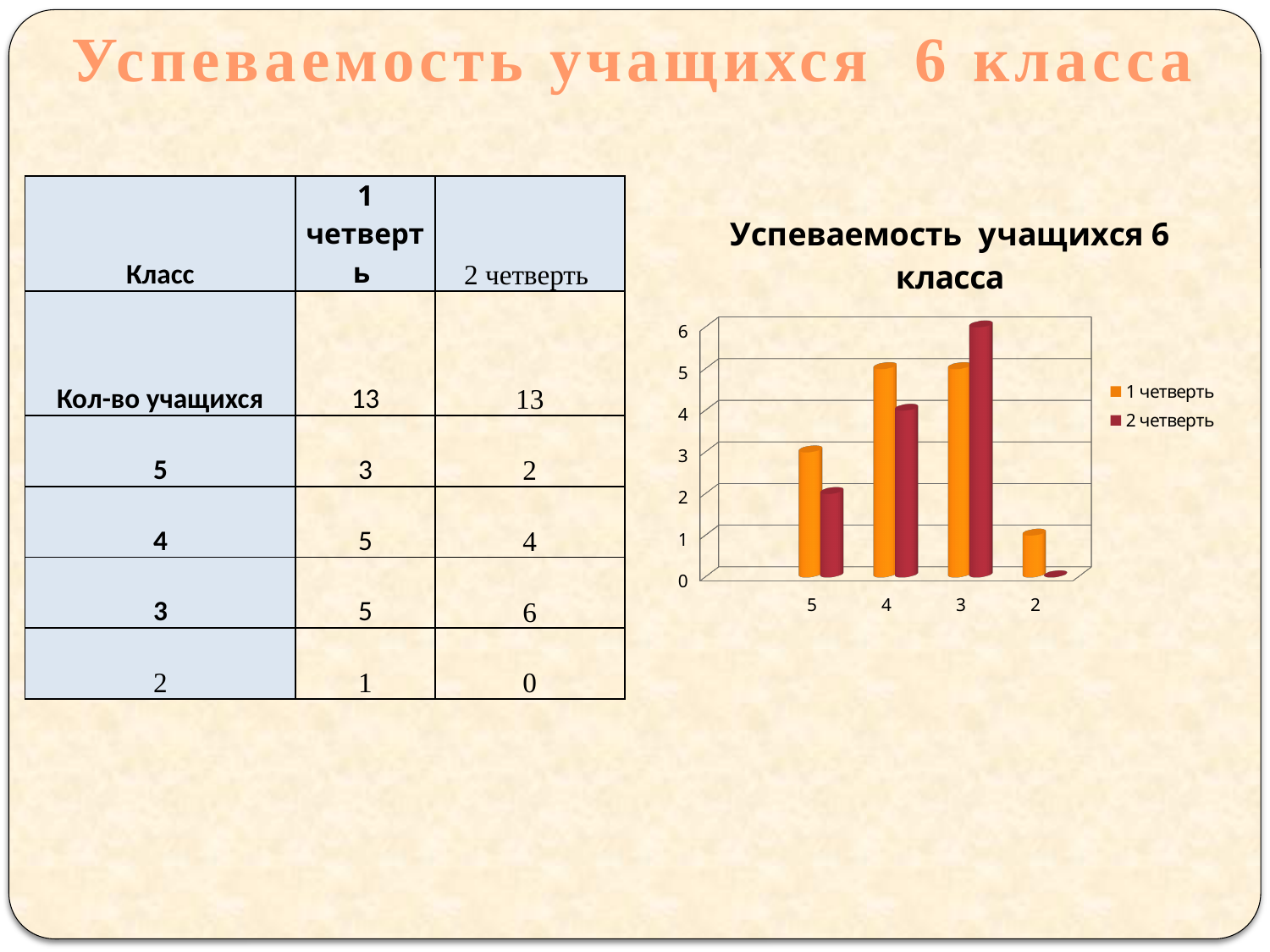
What is the title of the chart? Успеваемость учащихся 6 класса Which colour represents the series "2 четверть" in the chart? dark red What is the value for category 2 in the series "2 четверть"? 0 What is the value for category 3 in the series "2 четверть"? 6 What kind of chart is shown on the slide? bar chart What is the value for category 5 in the series "1 четверть"? 3 How many series does the chart legend list? 2 Which category has the lowest value in the series "1 четверть"? 2 How many categories are shown on the x axis of the chart? 4 What is the difference between the "2 четверть" and "1 четверть" values for category 3? 1 Which category has the highest value in the series "2 четверть"? 3 For category 4, which series has the larger value, "1 четверть" or "2 четверть"? 1 четверть